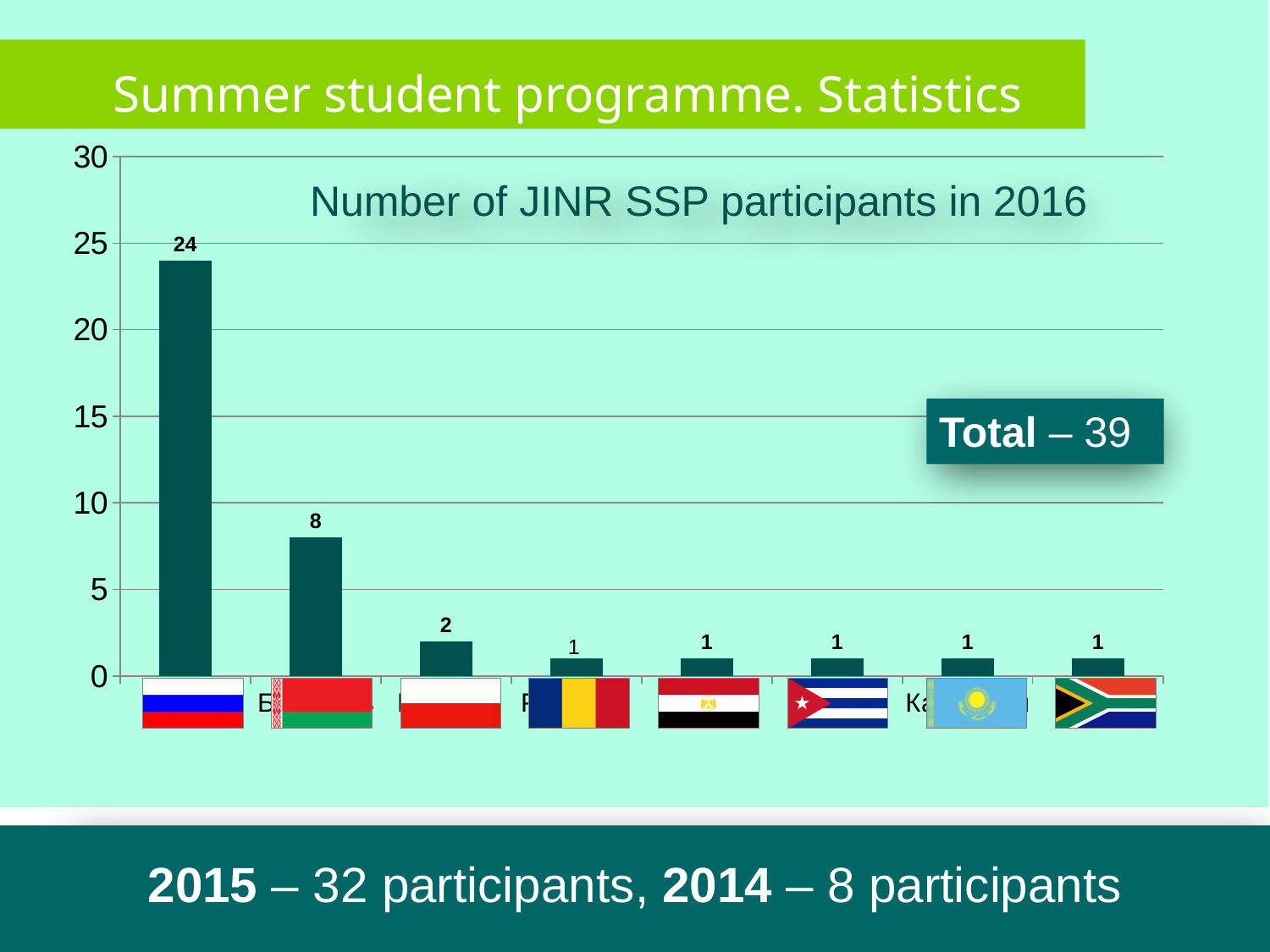
What kind of chart is shown on the slide? bar chart Which is larger, the second bar from the left or the third bar from the left? the second bar from the left How many bars are plotted in the chart? 8 What is the difference between the first bar from the left and the second bar from the left? 16 What is the value of the third bar from the left? 2 What is the title of the chart? Number of JINR SSP participants in 2016 What is the value of the second bar from the left? 8 What total number of participants is stated on the slide for 2016? 39 Do the bar values rise or fall from left to right across the chart? fall What is the value of the tallest bar in the chart? 24 Is the value of the first bar from the left greater or less than 20? greater How many bars in the chart have a value of 1? 5